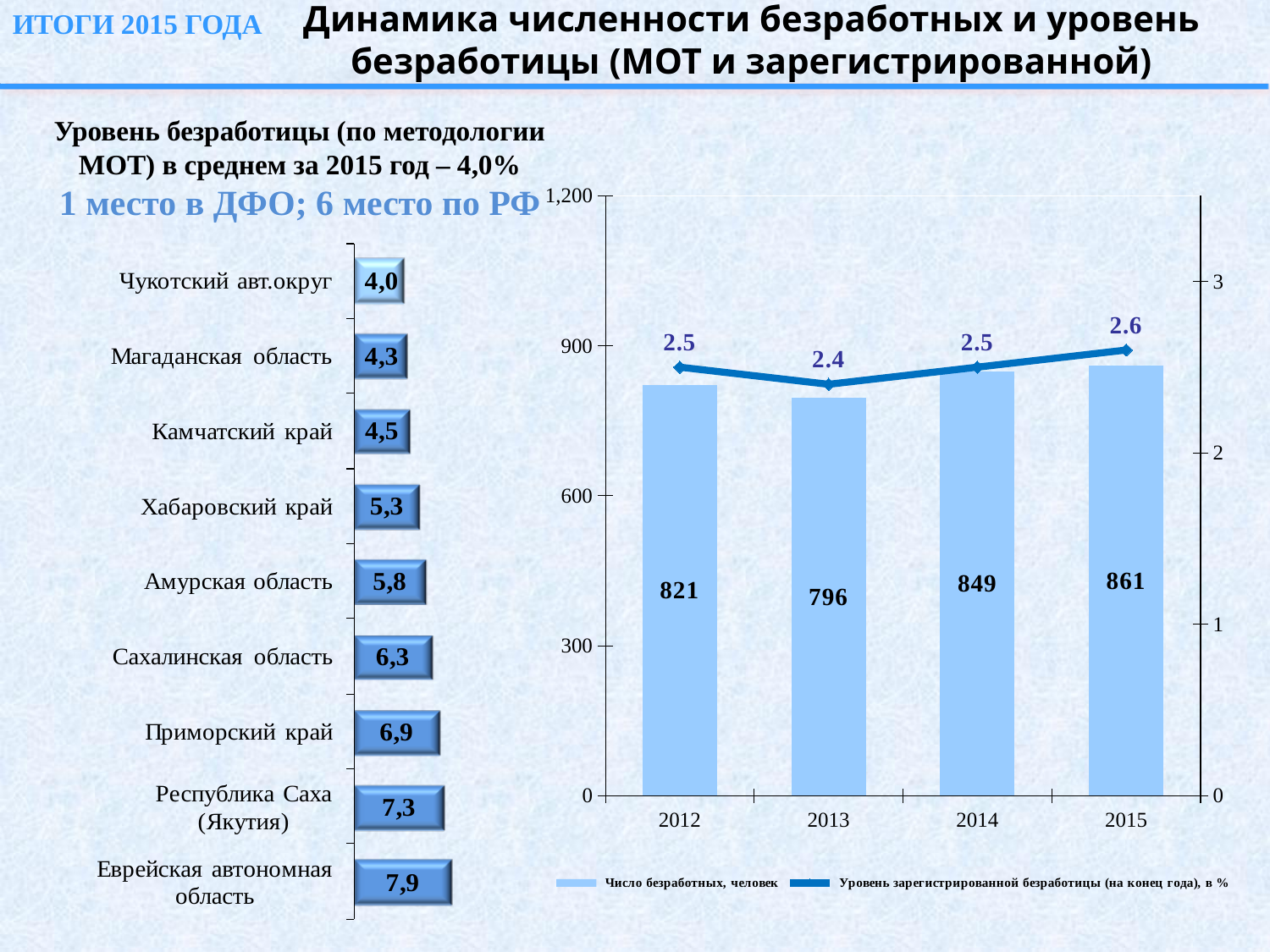
In the right chart, what is the registered unemployment rate (Уровень зарегистрированной безработицы) for 2015? 2.6 In the left chart of unemployment rates by region, what is the difference between the values for Приморский край and Камчатский край? 2,4 In the right chart, is the number of unemployed for 2014 greater or less than 900? less In the right chart, what is the difference in the number of unemployed between 2015 and 2012? 40 In the right chart, which year has the highest number of unemployed? 2015 In the right chart, how many unemployed people (Число безработных) are shown for 2013? 796 In the left chart of unemployment rates by region, which is larger: the value for Сахалинская область or Амурская область? Сахалинская область In the left chart of unemployment rates by region, how many regions are shown? 9 In the left chart of unemployment rates by region, which region has the highest value? Еврейская автономная область In the left chart of unemployment rates by region, what is the value for Хабаровский край? 5,3 In the left chart of unemployment rates by region, which region has the lowest value? Чукотский авт.округ In the right chart, how many series does the legend list? 2